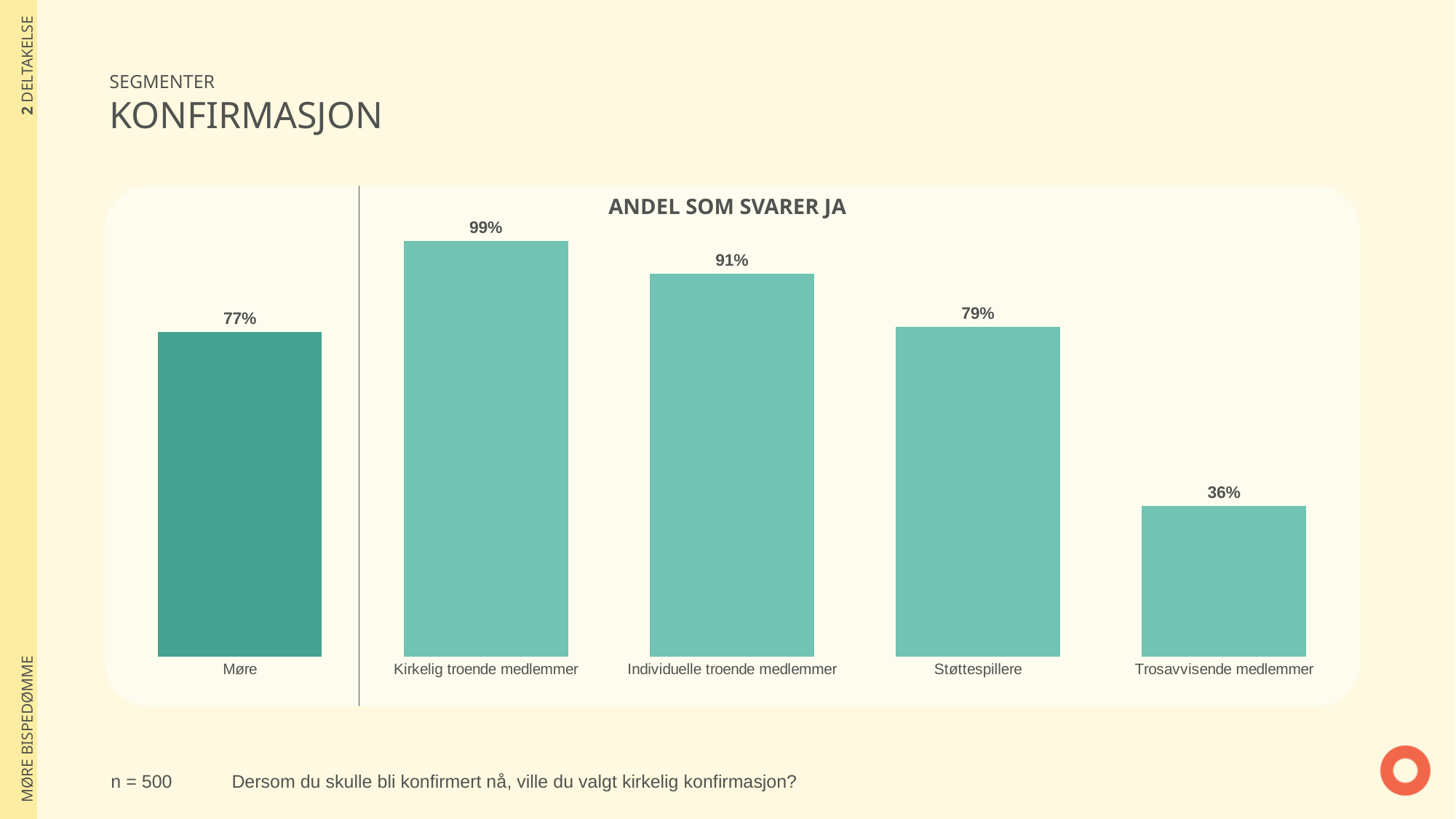
What is the title of the chart? ANDEL SOM SVARER JA What is the value for Møre? 77% Which is larger, the value for Møre or the value for Støttespillere? Støttespillere What is the difference between the values for Kirkelig troende medlemmer and Individuelle troende medlemmer? 8% What kind of chart is shown on the slide? Bar chart How many categories are shown in the chart? 5 What is the difference between the values for Støttespillere and Trosavvisende medlemmer? 43% What is the value for Støttespillere? 79% Which category has the lowest value? Trosavvisende medlemmer Which category has the highest value? Kirkelig troende medlemmer What is the value for Trosavvisende medlemmer? 36% What is the value for Kirkelig troende medlemmer? 99%